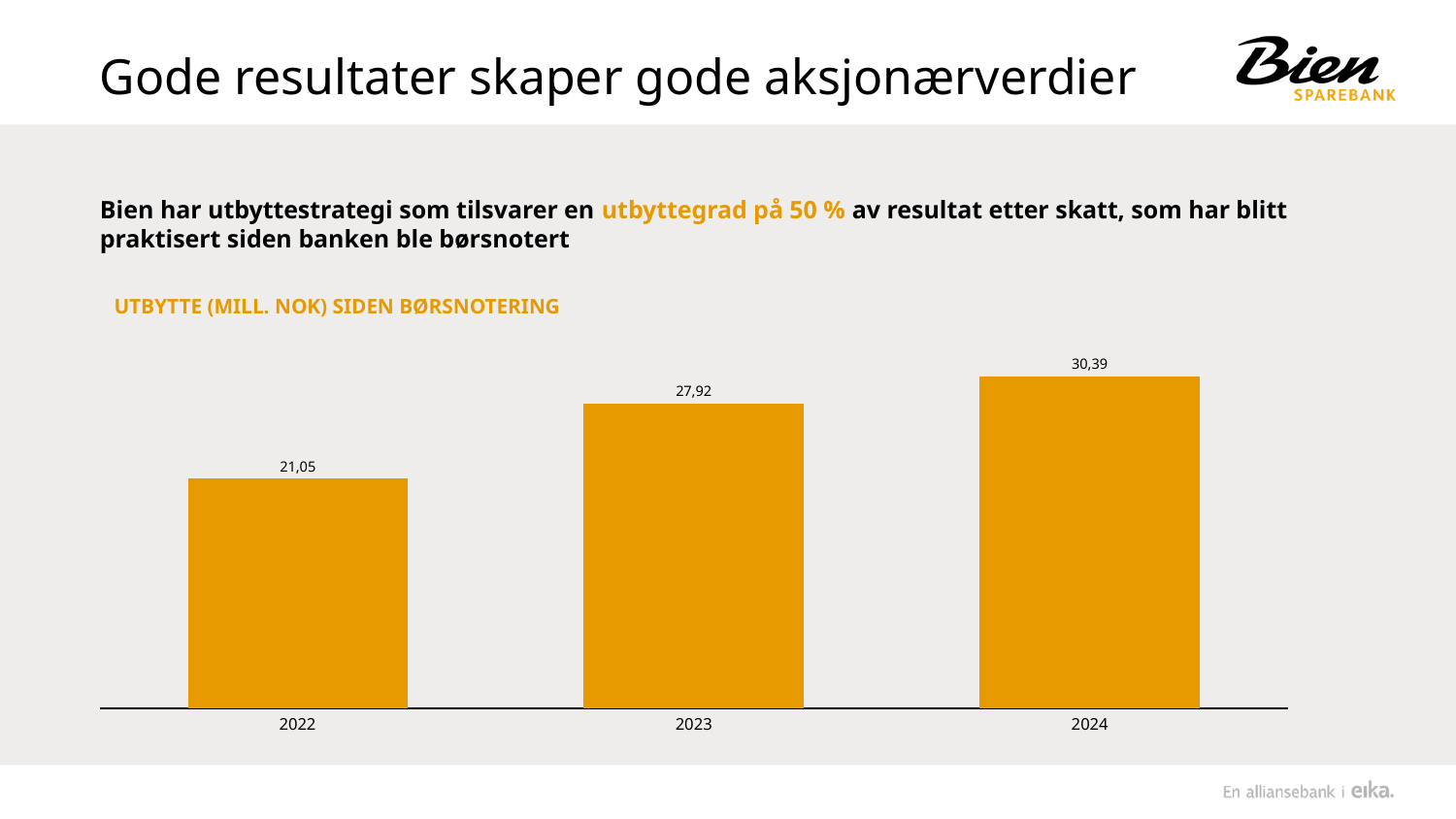
How many years are shown in the chart? 3 What is the difference between the dividend in 2023 and in 2022? 6,87 Which year has the lowest dividend? 2022 What is the dividend value shown for 2024? 30,39 Which year has the highest dividend? 2024 Do the dividend values rise or fall from 2022 to 2024? Rise What is the dividend value shown for 2022? 21,05 What is the dividend value shown for 2023? 27,92 What is the title of the chart? UTBYTTE (MILL. NOK) SIDEN BØRSNOTERING What is the difference between the dividend in 2024 and in 2022? 9,34 What kind of chart is shown on the slide? Bar chart Which is larger, the dividend in 2023 or in 2024? 2024